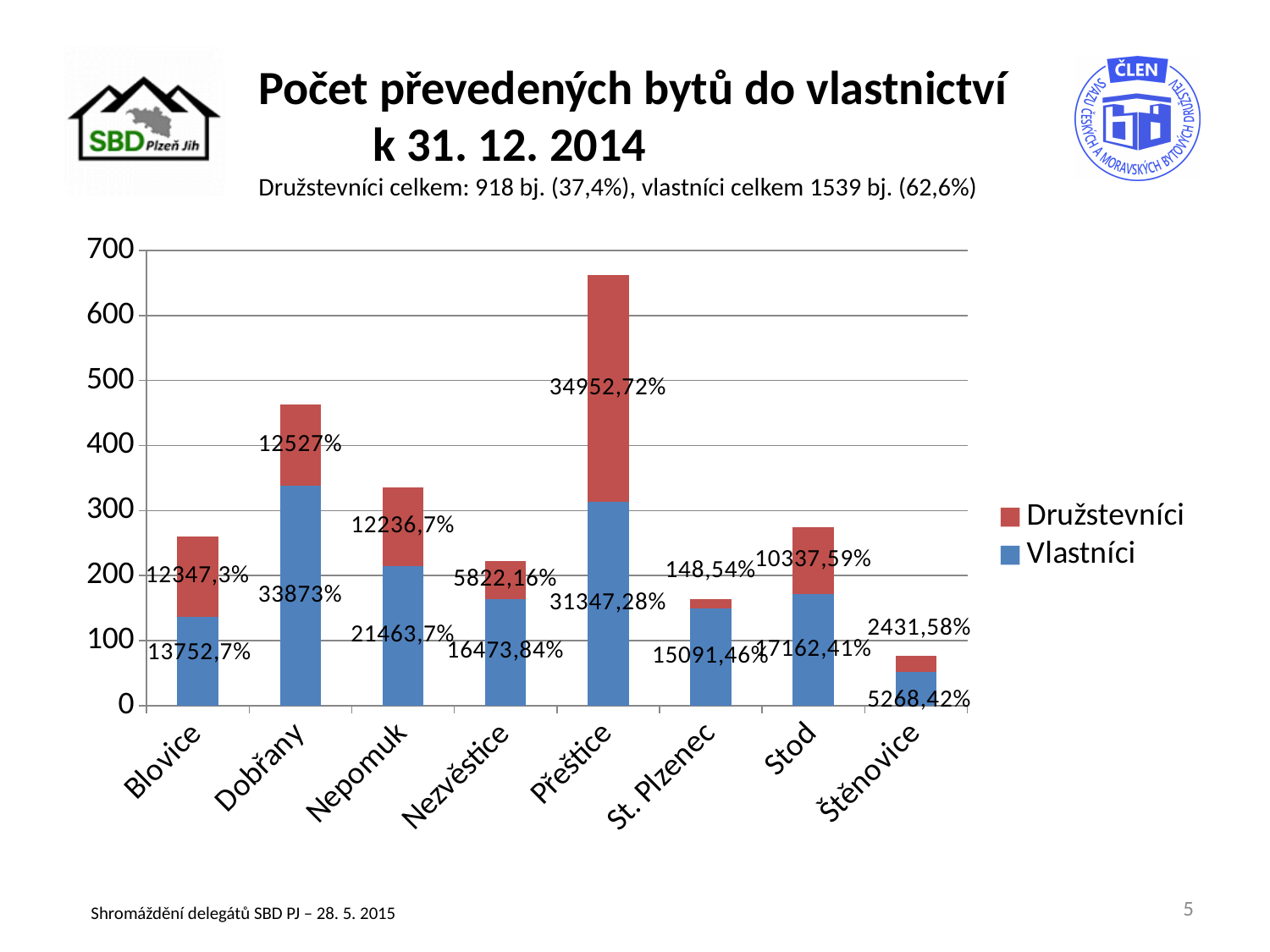
Is the total stacked bar for Štěnovice greater or less than 100? less What kind of chart is shown on the slide? Stacked bar chart Is the total stacked bar for Přeštice greater or less than 600? greater Which colour represents the Družstevníci series in the legend? Red Which has the taller stacked bar, Dobřany or Nepomuk? Dobřany Which category has the largest Družstevníci segment? Přeštice Which has the taller stacked bar, Stod or Nezvěstice? Stod How many series does the legend list? 2 Which category has the shortest stacked bar overall? Štěnovice How many categories are shown on the x axis? 8 Is the total stacked bar for St. Plzenec greater or less than 200? less Which category has the tallest stacked bar overall? Přeštice